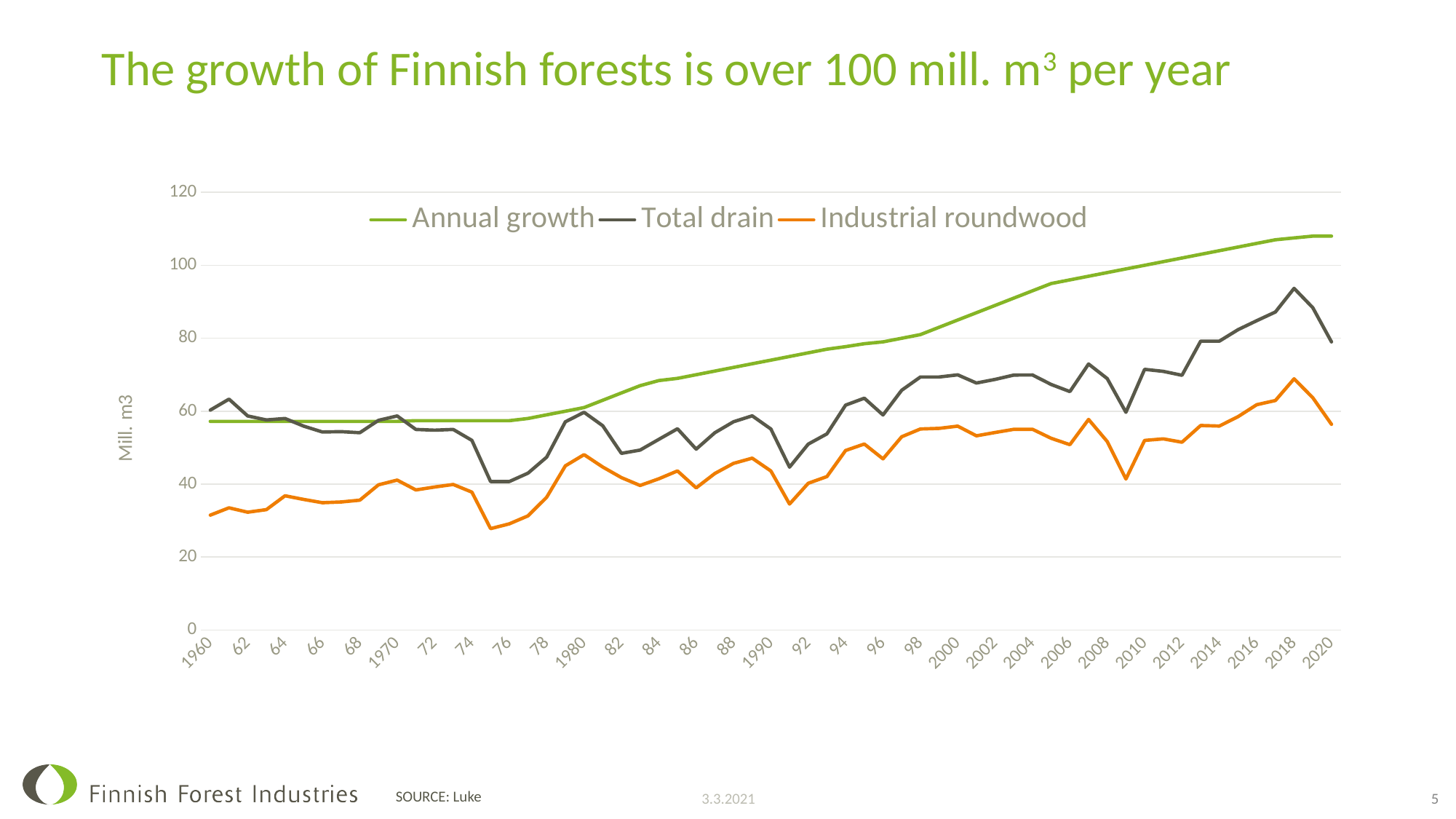
Does the Annual growth line generally rise or fall from 1980 to 2020? Rise Is the value for Industrial roundwood in 1960 greater or less than 40? less In 2000, which is larger: Total drain or Industrial roundwood? Total drain What is the label on the vertical axis? Mill. m3 Is the value for Annual growth in 2020 greater or less than 100? greater How many series does the legend list? 3 What kind of chart is shown on the slide? Line chart Which series is plotted in orange? Industrial roundwood In 2020, which is larger: Annual growth or Total drain? Annual growth Is the value for Industrial roundwood in 2018 greater or less than 60? greater